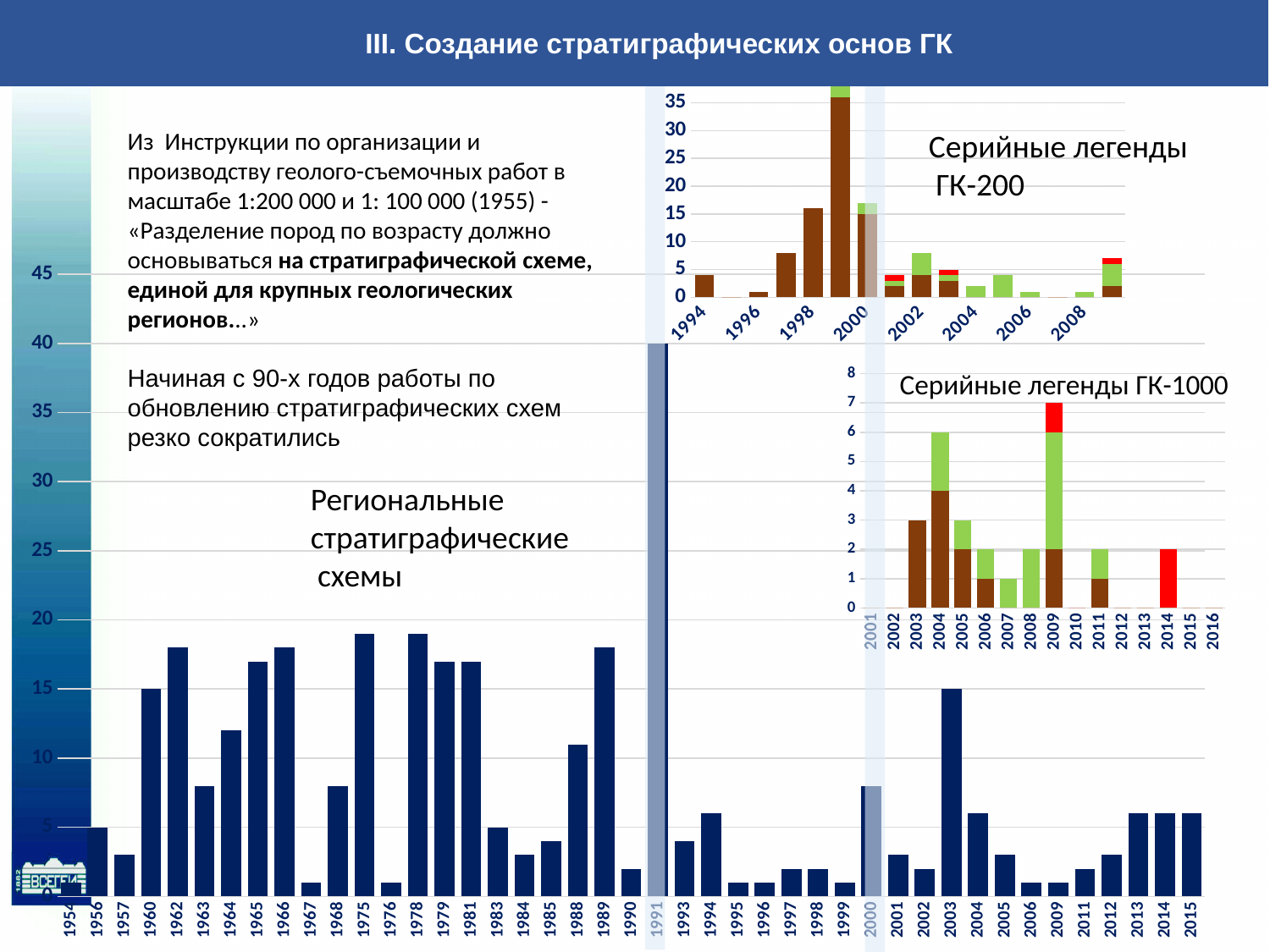
In the 'Региональные стратиграфические схемы' chart, is the value for 1975 greater or less than 15? greater In the 'Региональные стратиграфические схемы' chart, which year has the larger value, 2003 or 2004? 2003 How many year labels are shown on the x axis of the 'Серийные легенды ГК-1000' chart? 16 In the 'Серийные легенды ГК-200' chart, is the value for 1999 greater or less than 30? greater In the 'Серийные легенды ГК-1000' chart, what is the total height of the stacked bar for 2009? 7 In the 'Серийные легенды ГК-1000' chart, what is the total height of the stacked bar for 2004? 6 In the 'Серийные легенды ГК-200' chart, which year has the highest bar? 1999 In the 'Серийные легенды ГК-1000' chart, which year has the tallest stacked bar? 2009 What kind of chart is the large chart at the bottom of the slide titled 'Региональные стратиграфические схемы'? bar chart In the 'Региональные стратиграфические схемы' chart, which year has the larger value, 1962 or 1963? 1962 In the 'Серийные легенды ГК-200' chart, is the value for 1996 greater or less than 5? less